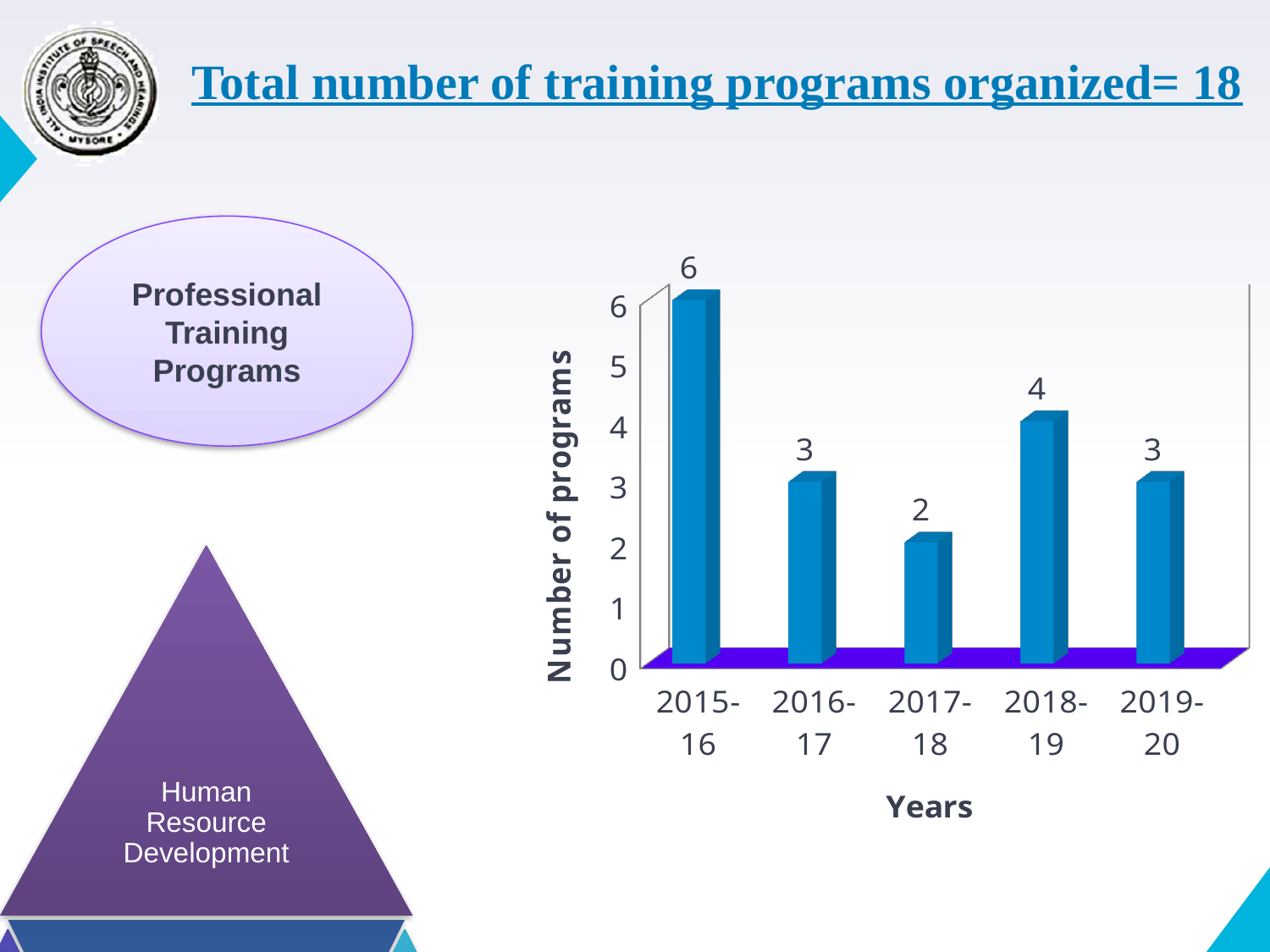
What is the label of the vertical axis of the chart? Number of programs Which year had more programs, 2016-17 or 2018-19? 2018-19 What kind of chart is shown on the slide? bar chart What is the number of programs for 2018-19? 4 Which year has the lowest number of programs? 2017-18 Which year has the highest number of programs? 2015-16 What is the label of the horizontal axis of the chart? Years What is the number of programs for 2017-18? 2 What is the difference between the number of programs in 2015-16 and 2018-19? 2 Is the value for 2018-19 greater or less than 3? greater How many training programs were organized in 2015-16? 6 How many years are shown on the x axis of the chart? 5